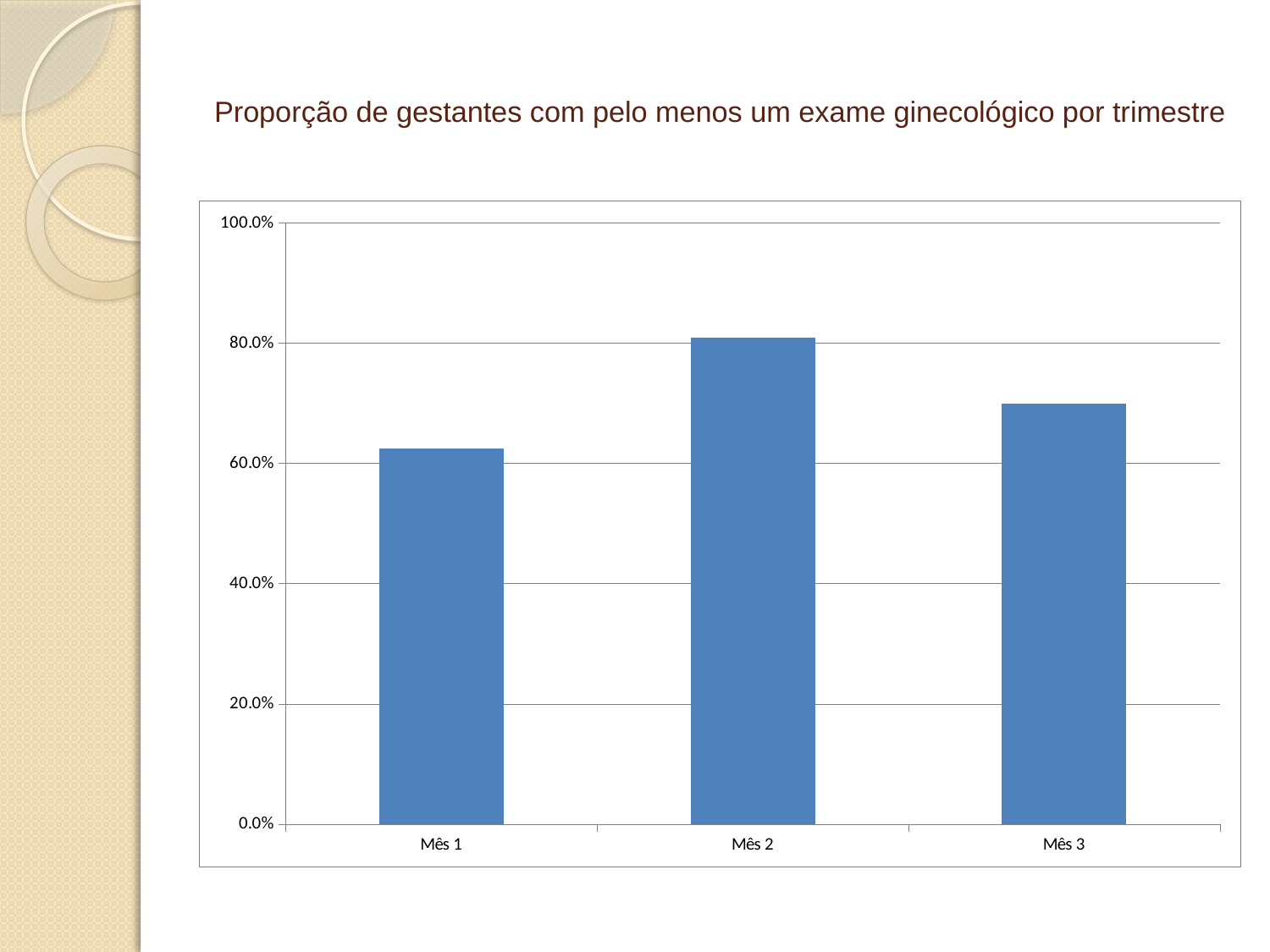
Is the value for Mês 2 greater or less than 60.0%? greater Which month has the lowest proportion in the chart? Mês 1 Is the value for Mês 1 greater or less than 60.0%? greater Which is larger, the value for Mês 2 or the value for Mês 3? Mês 2 What type of chart is shown on the slide? bar chart How many categories are shown on the x axis of the chart? 3 What is the title of the slide above the chart? Proporção de gestantes com pelo menos um exame ginecológico por trimestre Is the value for Mês 3 greater or less than 80.0%? less Which is larger, the value for Mês 1 or the value for Mês 3? Mês 3 What is the highest value shown on the y axis of the chart? 100.0% Which month has the highest proportion in the chart? Mês 2